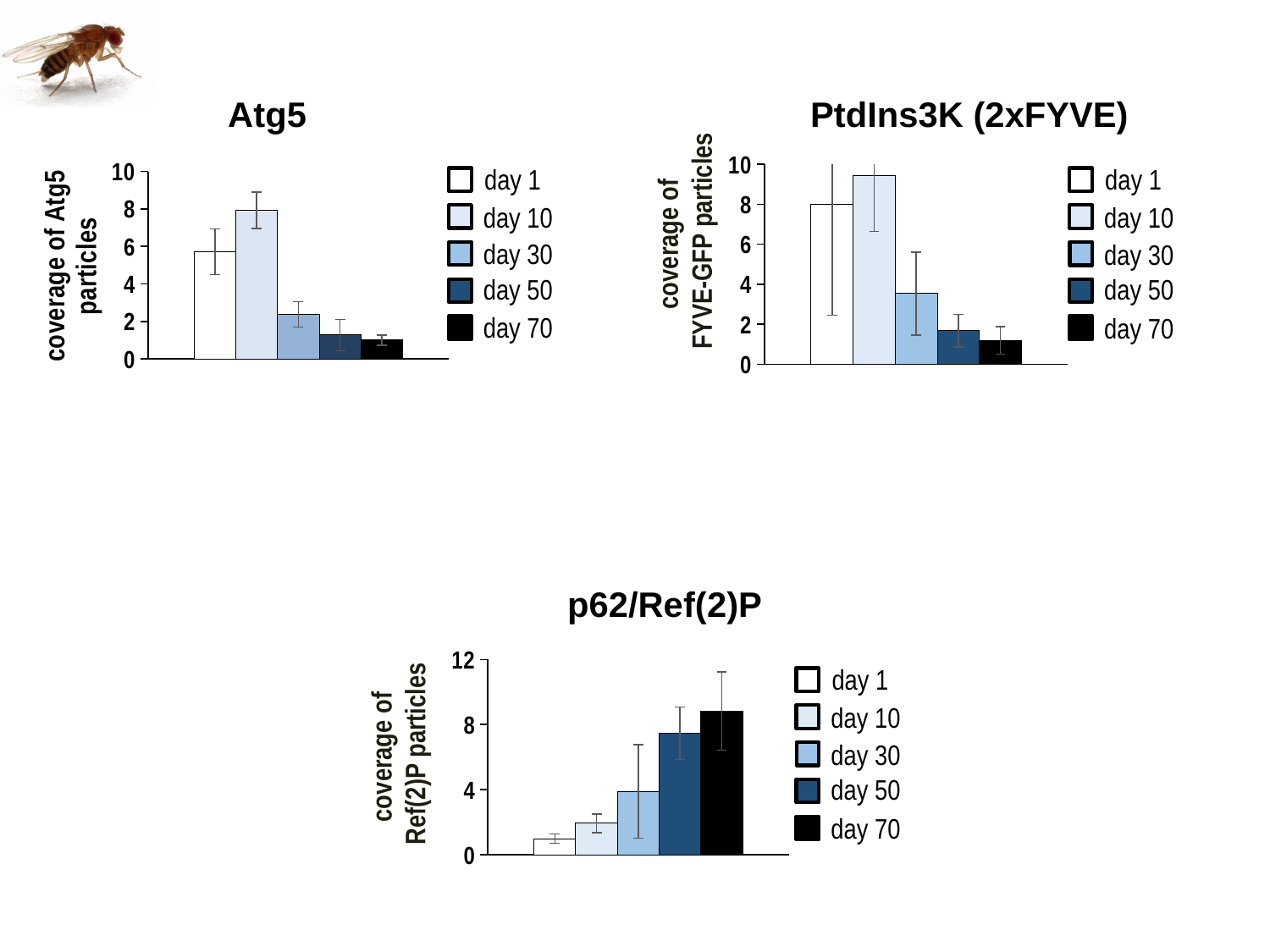
In the PtdIns3K (2xFYVE) chart, which day has the highest coverage of FYVE-GFP particles? day 10 How many entries does the legend of the p62/Ref(2)P chart list? 5 In the Atg5 chart, is the value for day 30 greater or less than 4? less In the p62/Ref(2)P chart, is the value for day 50 greater or less than 4? greater In the Atg5 chart, which day has the highest coverage of Atg5 particles? day 10 In the PtdIns3K (2xFYVE) chart, which is larger, the value for day 50 or the value for day 30? day 30 In the p62/Ref(2)P chart, which day has the lowest coverage of Ref(2)P particles? day 1 In the p62/Ref(2)P chart, which day has the highest coverage of Ref(2)P particles? day 70 In the p62/Ref(2)P chart, do the values rise or fall from day 1 to day 70? rise In the Atg5 chart, is the value for day 10 greater or less than 6? greater In the Atg5 chart, which is larger, the value for day 1 or the value for day 30? day 1